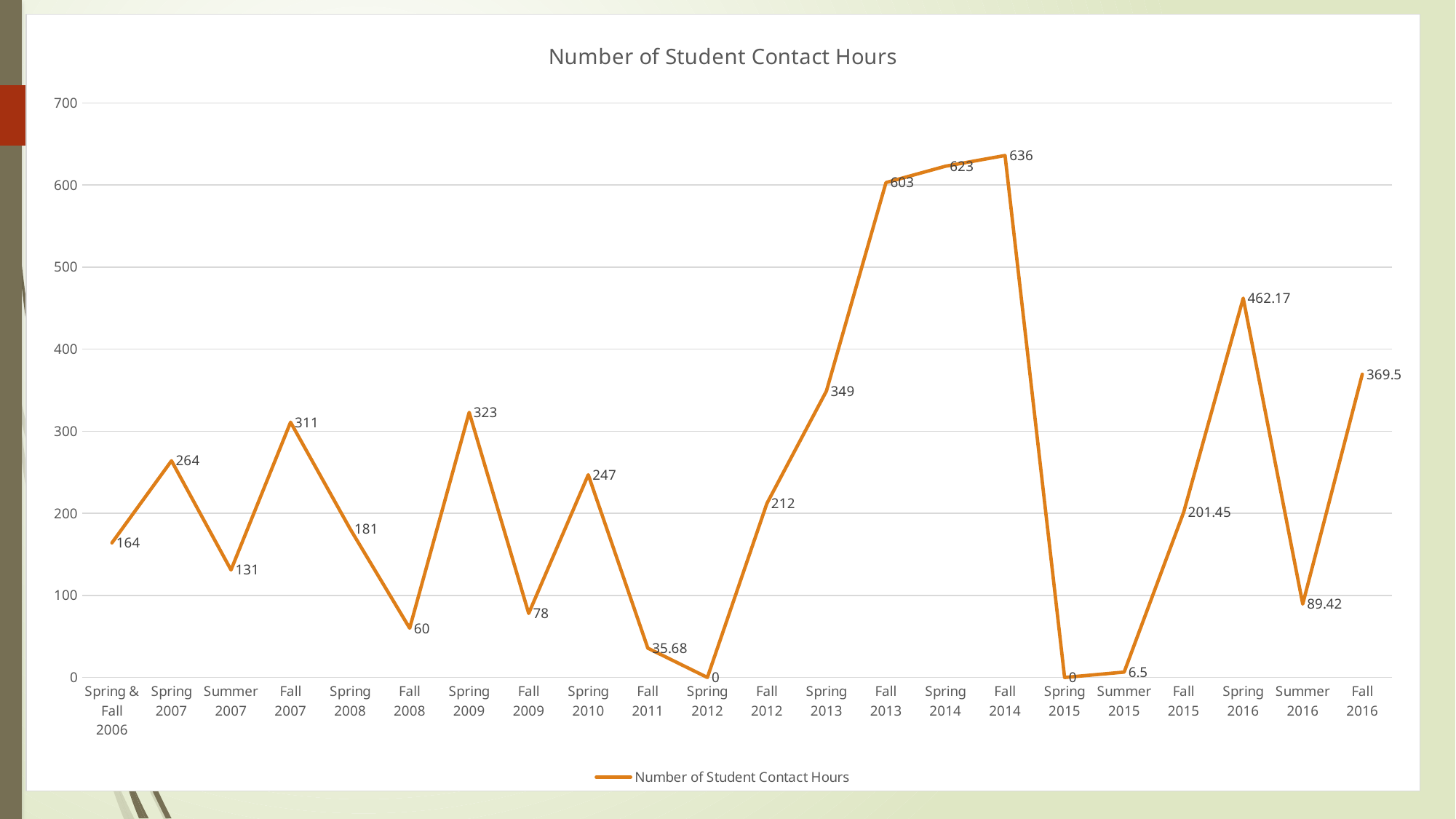
What is the number of student contact hours for Spring 2016? 462.17 Which has more student contact hours, Spring 2007 or Spring 2010? Spring 2007 What is the difference in student contact hours between Fall 2014 and Fall 2013? 33 How many series does the legend list? 1 What type of chart is shown on the slide? line chart Which period has the highest number of student contact hours? Fall 2014 What is the difference in student contact hours between Spring 2009 and Fall 2009? 245 What is the number of student contact hours for Fall 2007? 311 How many periods are plotted on the x axis? 22 What is the title of the chart? Number of Student Contact Hours What is the number of student contact hours for Fall 2011? 35.68 Which has more student contact hours, Spring 2013 or Fall 2016? Fall 2016